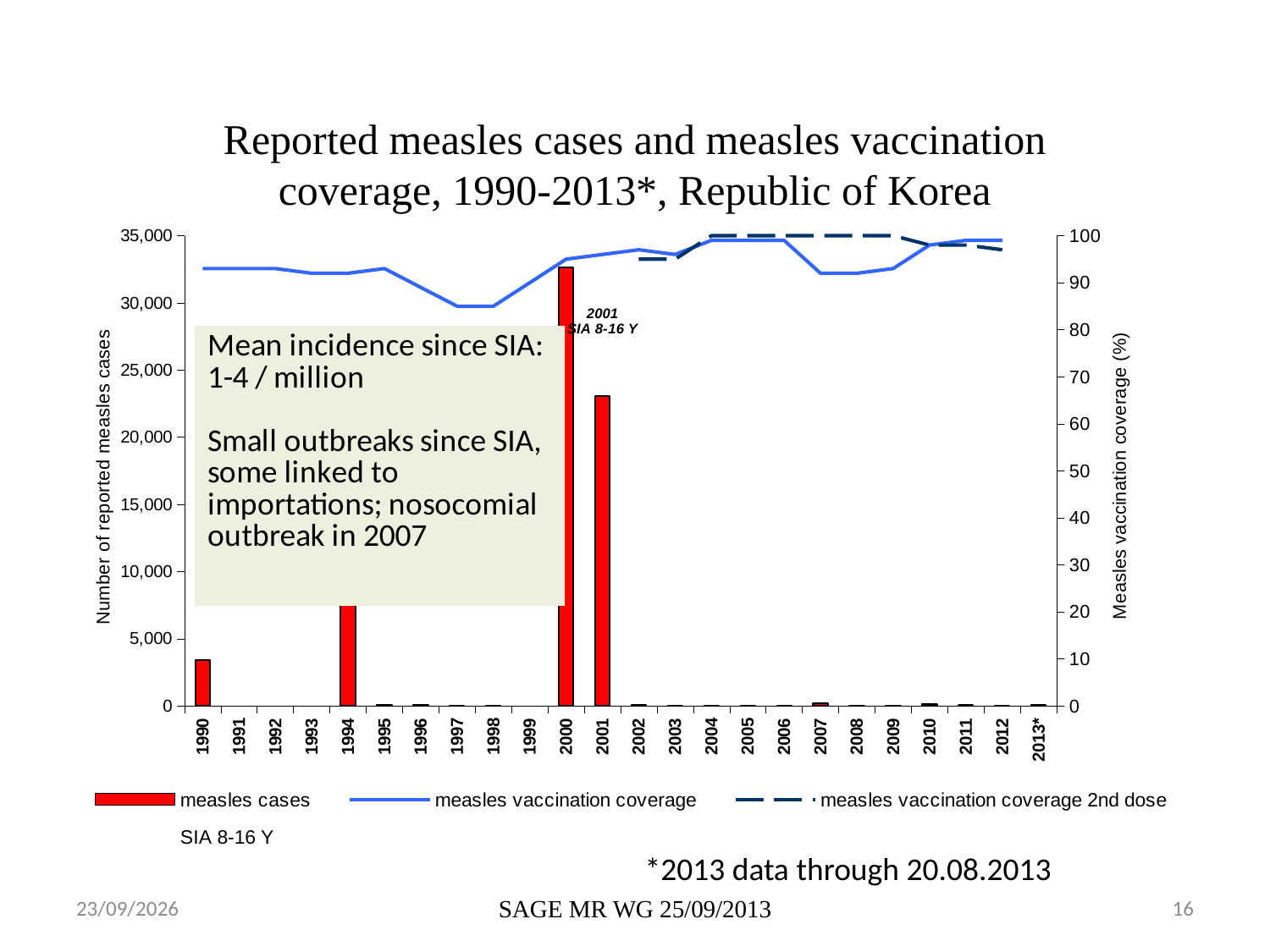
How many series does the legend list? 4 What kind of chart is shown on the slide? A combined bar and line chart How many years are shown along the x axis? 24 Is the number of reported measles cases in 2001 greater or less than 25,000? less Does the measles vaccination coverage line rise or fall between 1998 and 2000? rise In which year is the number of reported measles cases highest? 2000 Is the measles vaccination coverage in 1997 greater or less than 90%? less Which year has more reported measles cases, 2000 or 2001? 2000 Is the number of reported measles cases in 1990 greater or less than 5,000? less What is the title of the chart? Reported measles cases and measles vaccination coverage, 1990-2013*, Republic of Korea